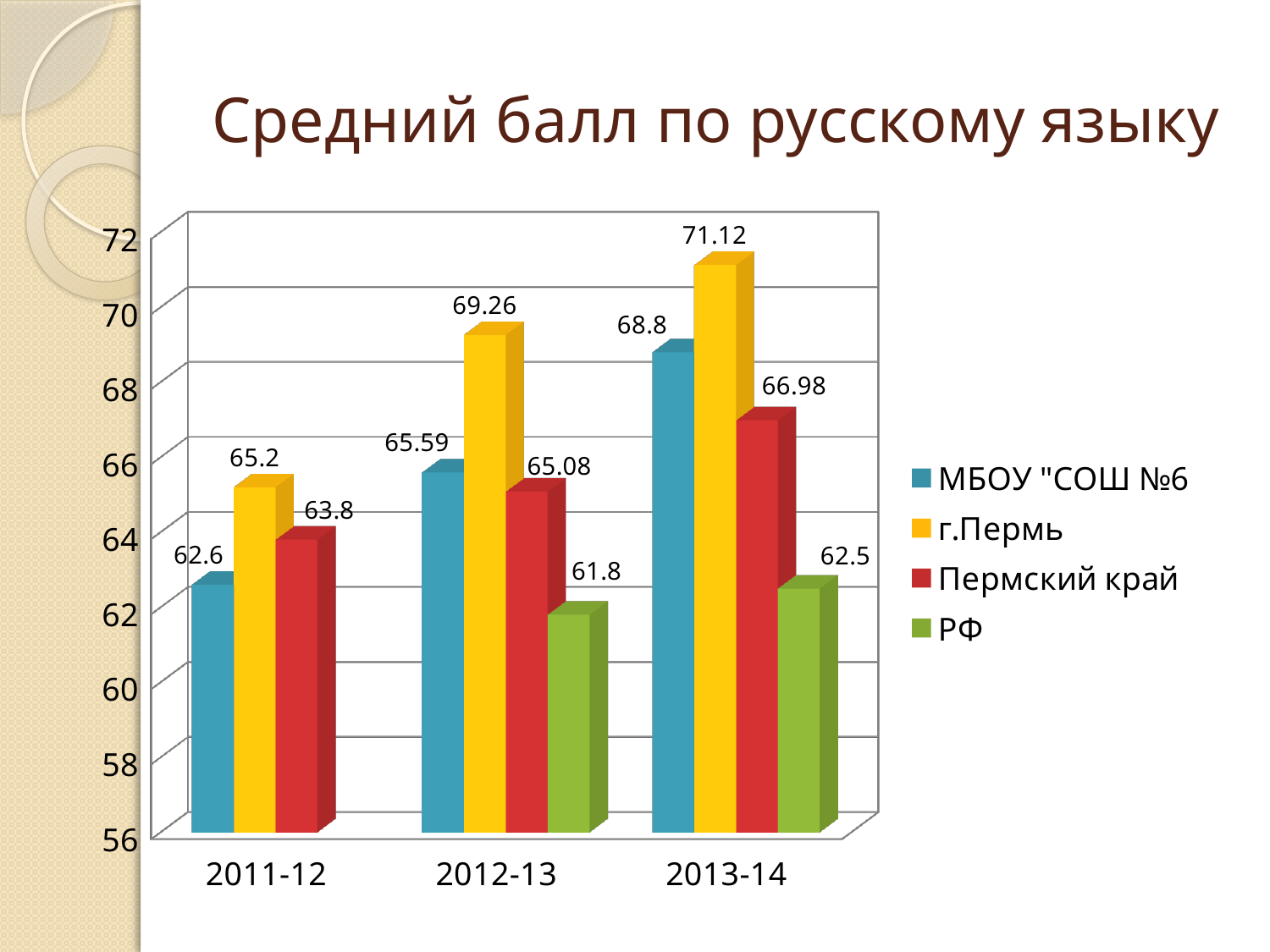
Which series has the lowest value in 2012-13? РФ How many series does the legend list? 4 What is the value for РФ in 2013-14? 62.5 What kind of chart is shown on the slide? Bar chart What is the difference between г.Пермь and МБОУ "СОШ №6 in 2011-12? 2.6 What is the value for Пермский край in 2012-13? 65.08 Which series has the highest value in 2013-14? г.Пермь Do the values for МБОУ "СОШ №6 rise or fall from 2011-12 to 2013-14? Rise Which is larger in 2012-13: МБОУ "СОШ №6 or Пермский край? МБОУ "СОШ №6 How many year categories are shown on the x axis? 3 What is the value for г.Пермь in 2013-14? 71.12 What is the value for МБОУ "СОШ №6 in 2011-12? 62.6